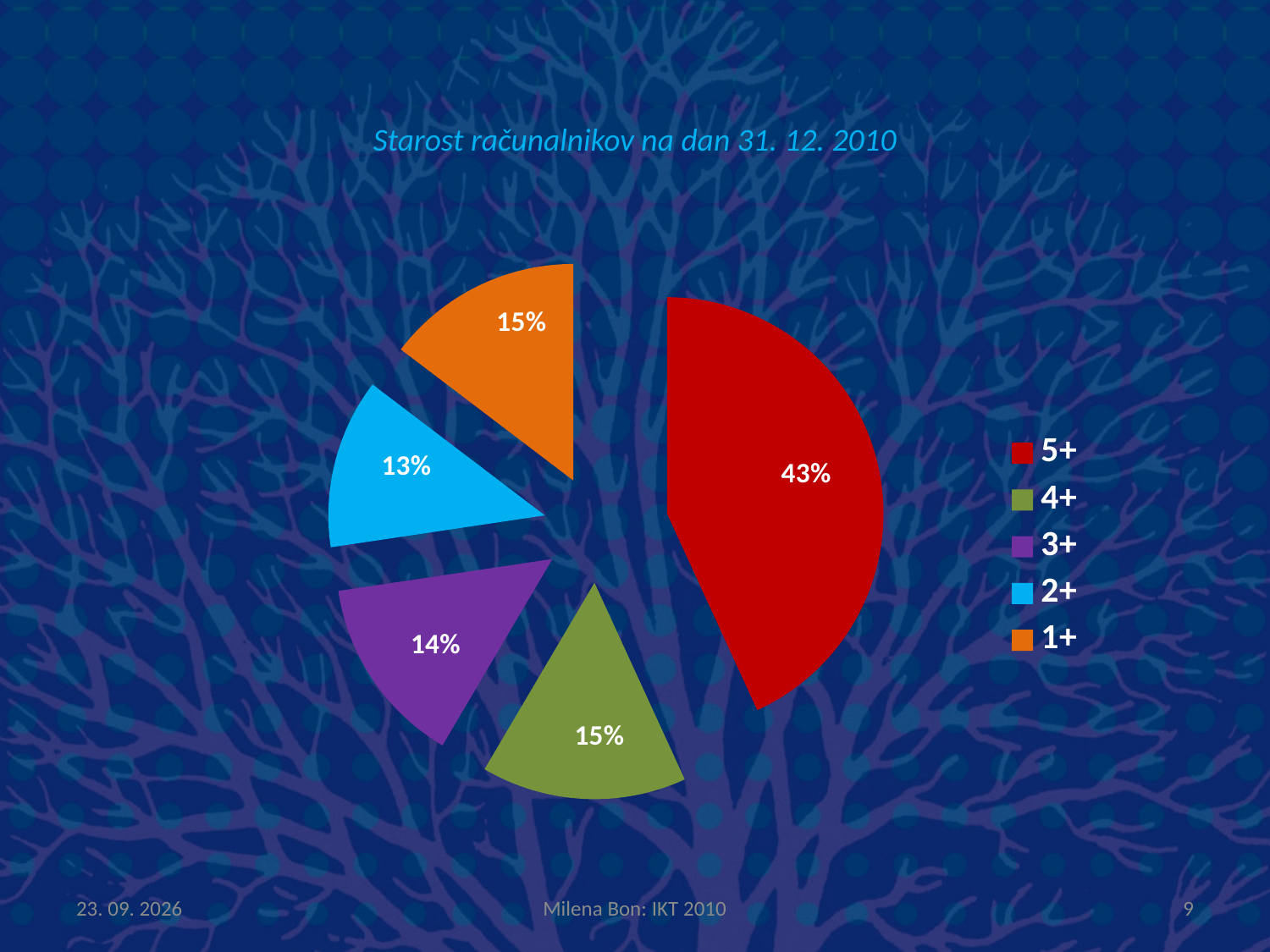
What colour is the 5+ slice in the pie chart? red Which category has the smallest slice of the pie? 2+ What share of the pie does the 5+ slice represent? 43% Which category has the largest slice of the pie? 5+ What share of the pie does the 3+ slice represent? 14% What is the difference in percentage points between the 5+ slice and the 4+ slice? 28 What type of chart is shown on the slide? pie chart How many slices does the pie chart have? 5 What share of the pie does the 2+ slice represent? 13% What share of the pie does the 1+ slice represent? 15% Which is larger, the 3+ slice or the 2+ slice? 3+ What is the title of the chart? Starost računalnikov na dan 31. 12. 2010